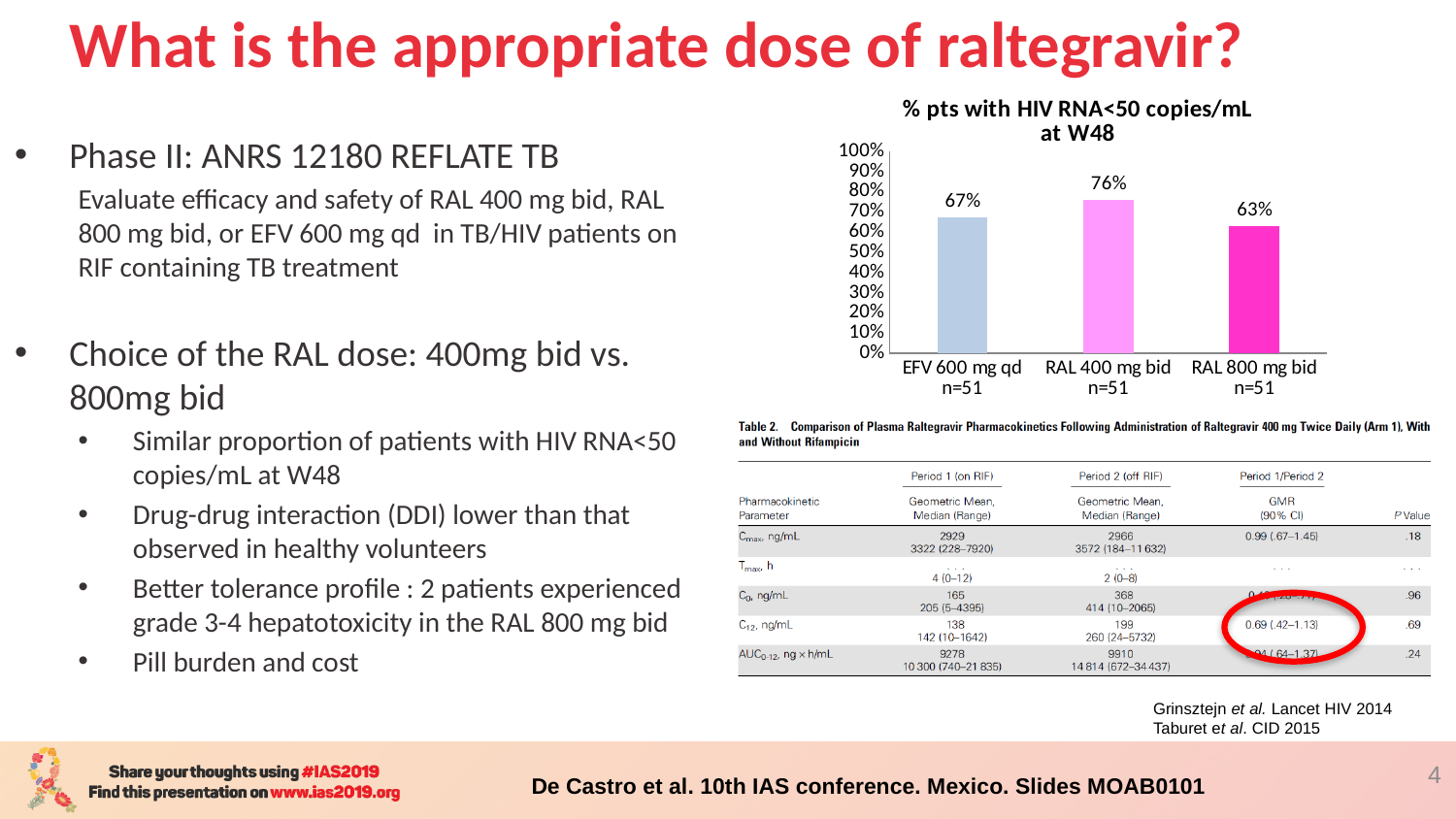
Which category has the lowest value in the bar chart? RAL 800 mg bid What is the value for EFV 600 mg qd in the bar chart? 67% What is the value for RAL 800 mg bid in the bar chart? 63% What kind of chart is shown on the slide? bar chart Which is larger, the value for EFV 600 mg qd or the value for RAL 800 mg bid? EFV 600 mg qd What is the value for RAL 400 mg bid in the bar chart? 76% How many categories are shown in the bar chart? 3 Which category has the highest value in the bar chart? RAL 400 mg bid What is the difference between the values for RAL 400 mg bid and EFV 600 mg qd? 9% What is the title of the bar chart? % pts with HIV RNA<50 copies/mL at W48 What is the difference between the values for RAL 400 mg bid and RAL 800 mg bid? 13% Is the value for RAL 800 mg bid greater or less than 70%? less